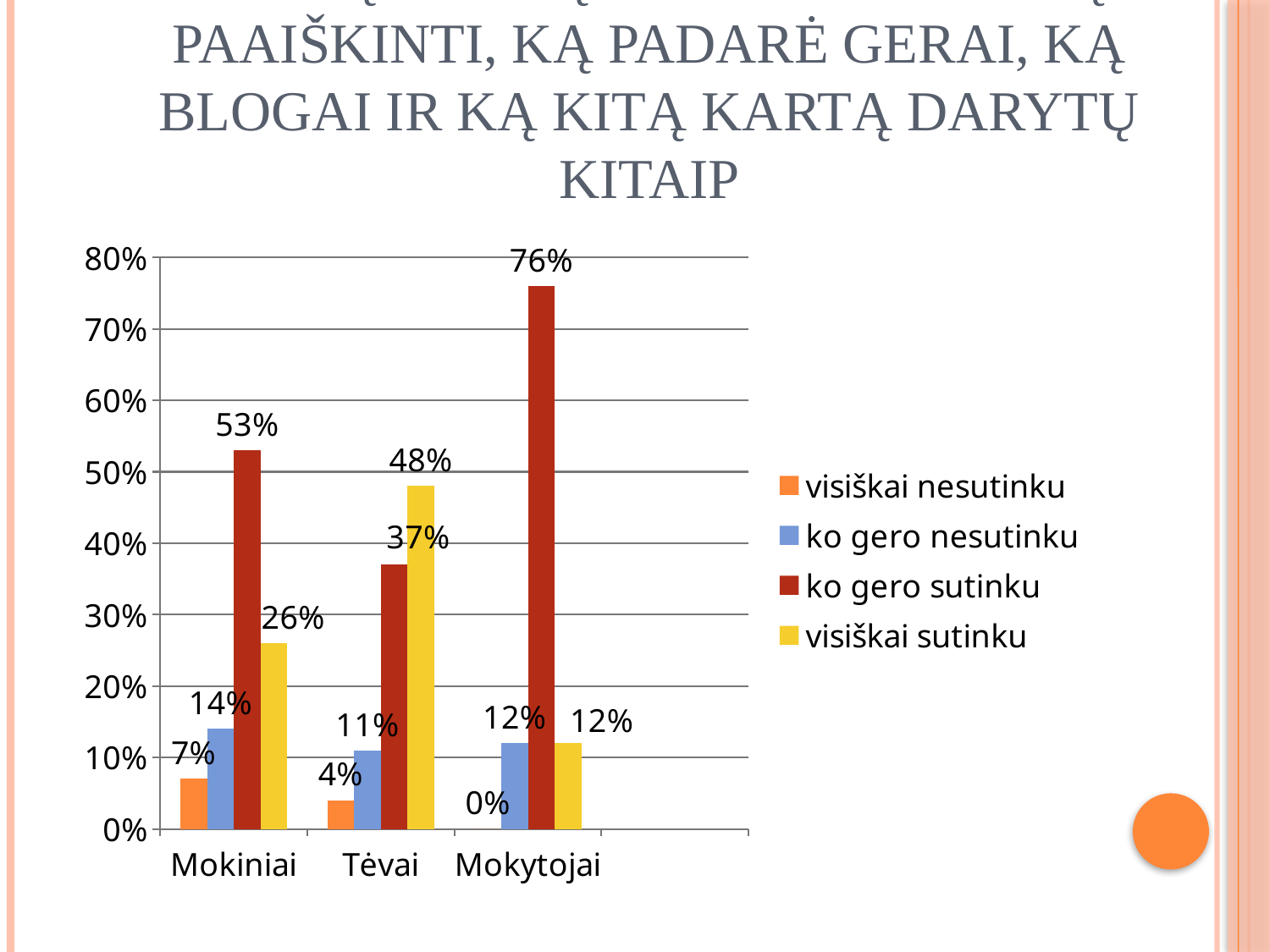
How many categories are shown on the x axis? 3 What colour represents the "visiškai sutinku" series? yellow What is the value for "ko gero sutinku" in the Mokytojai category? 76% What is the value for "visiškai sutinku" in the Tėvai category? 48% Which is larger for Tėvai: "ko gero sutinku" or "visiškai sutinku"? visiškai sutinku What kind of chart is shown on the slide? bar chart Which category has the lowest value for "visiškai nesutinku"? Mokytojai What is the value for "visiškai nesutinku" in the Mokiniai category? 7% How many series does the legend list? 4 What is the difference between the "ko gero sutinku" values for Mokytojai and Mokiniai? 23% What is the value for "ko gero nesutinku" in the Tėvai category? 11% Which category has the highest value for "ko gero sutinku"? Mokytojai